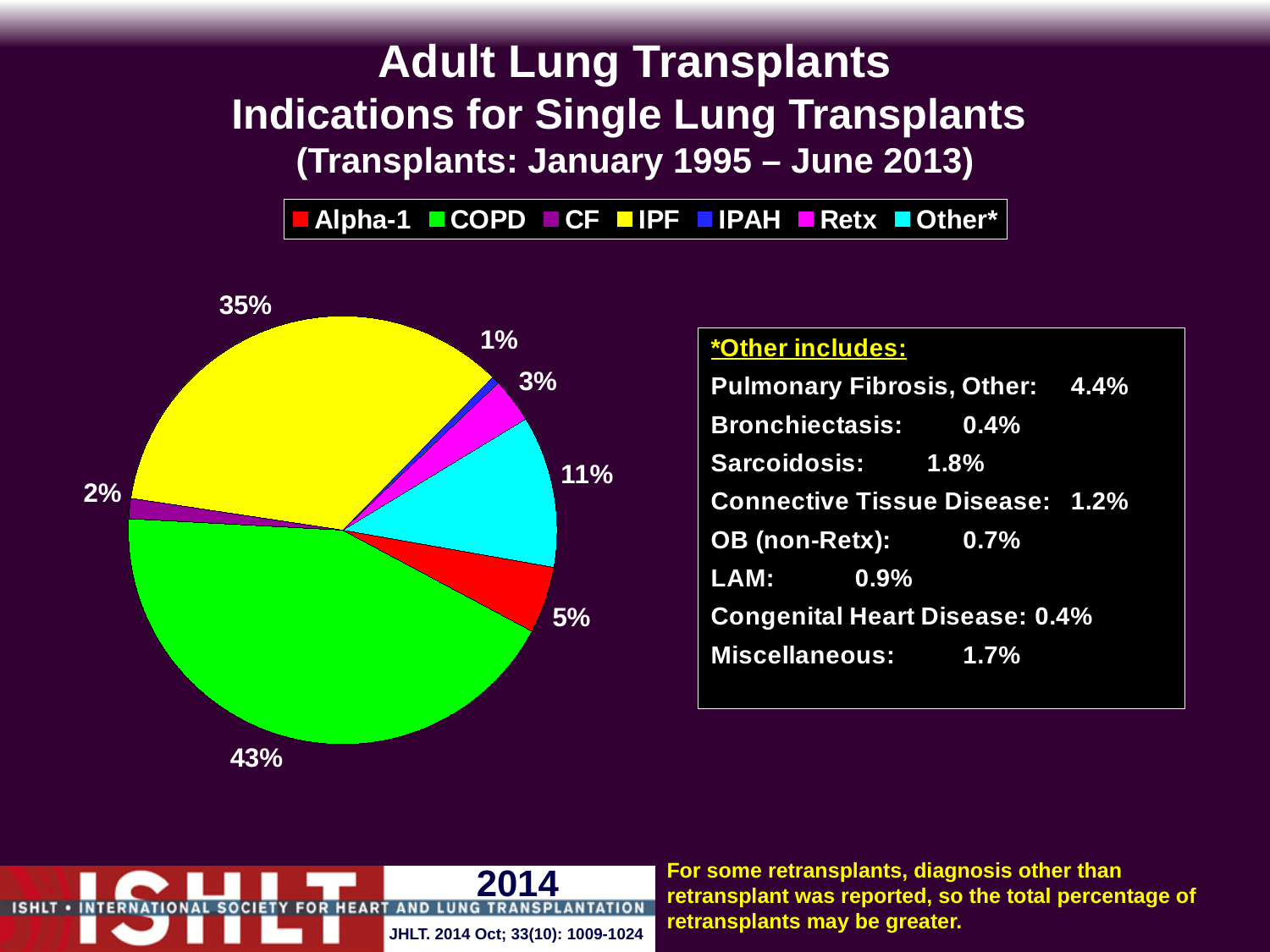
What percentage of single lung transplants is attributed to Alpha-1? 5% What percentage of single lung transplants is attributed to COPD? 43% What is the difference in percentage points between COPD and IPF? 8 How many indications does the legend list? 7 What percentage of single lung transplants is attributed to Other*? 11% What percentage of single lung transplants is attributed to IPF? 35% What percentage of single lung transplants is attributed to IPAH? 1% Which colour represents IPF in the pie chart? yellow Which indication has the smallest share of the pie? IPAH Which has a larger share, Retx or CF? Retx What kind of chart is shown on the slide? pie chart Which indication has the largest share of the pie? COPD